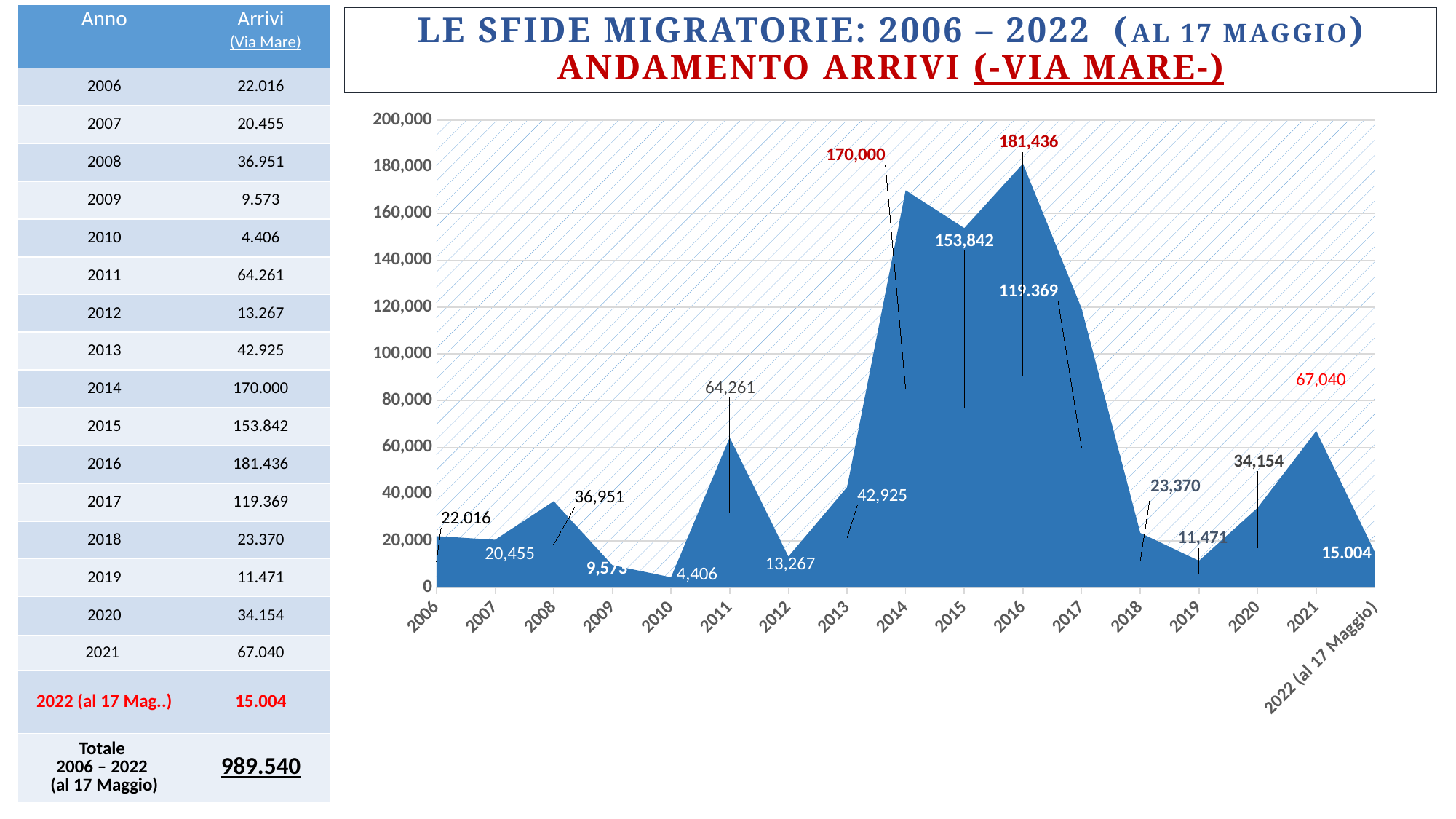
What is the value of arrivals shown for 2022 (al 17 Maggio)? 15.004 Which year has the lowest value of arrivals? 2010 Is the value for 2017 greater or less than 100,000? greater What is the difference between the arrivals in 2016 and in 2015? 27,594 Do the values rise or fall from 2016 to 2019? fall How many years are plotted on the x axis of the chart? 17 What kind of chart is shown on the slide? area chart Which year has more arrivals, 2014 or 2017? 2014 What is the value of arrivals shown for 2021? 67,040 What is the value of arrivals shown for 2010? 4,406 What is the value of arrivals shown for 2016? 181,436 Which year has the highest value of arrivals? 2016